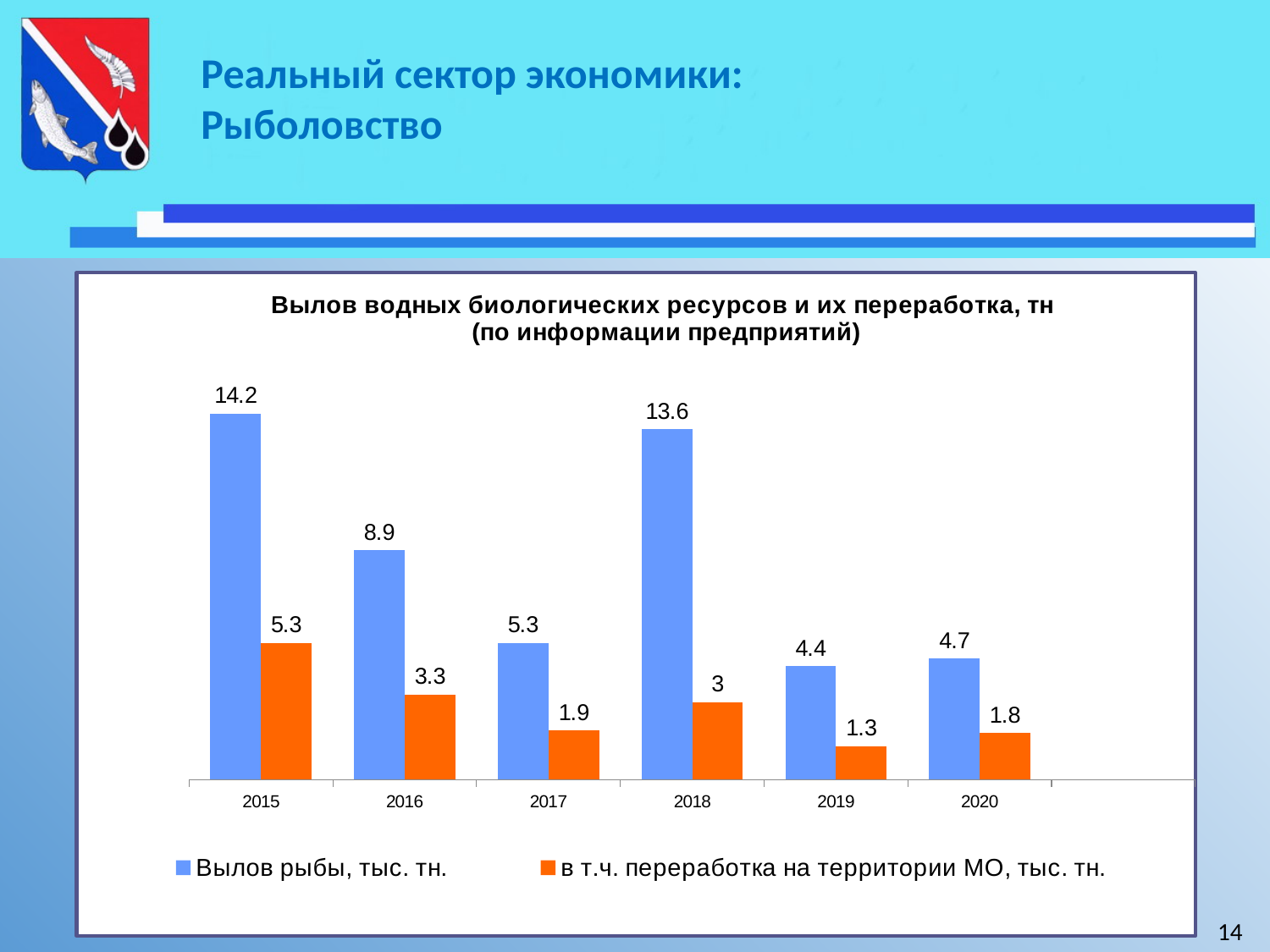
What colour are the bars for 'в т.ч. переработка на территории МО, тыс. тн.'? Orange What is the difference between 'Вылов рыбы, тыс. тн.' and 'в т.ч. переработка на территории МО, тыс. тн.' in 2016? 5.6 How many series does the legend list? 2 What kind of chart is shown on the slide? Bar chart What is the value of 'в т.ч. переработка на территории МО, тыс. тн.' for 2018? 3 Which year has the highest value for 'Вылов рыбы, тыс. тн.'? 2015 Which year has the lowest value for 'в т.ч. переработка на территории МО, тыс. тн.'? 2019 Which is larger: 'Вылов рыбы, тыс. тн.' in 2019 or in 2020? 2020 How many years are shown on the x axis? 6 What is the difference between 'Вылов рыбы, тыс. тн.' in 2015 and in 2018? 0.6 What is the value of 'Вылов рыбы, тыс. тн.' for 2020? 4.7 What is the value of 'Вылов рыбы, тыс. тн.' for 2015? 14.2